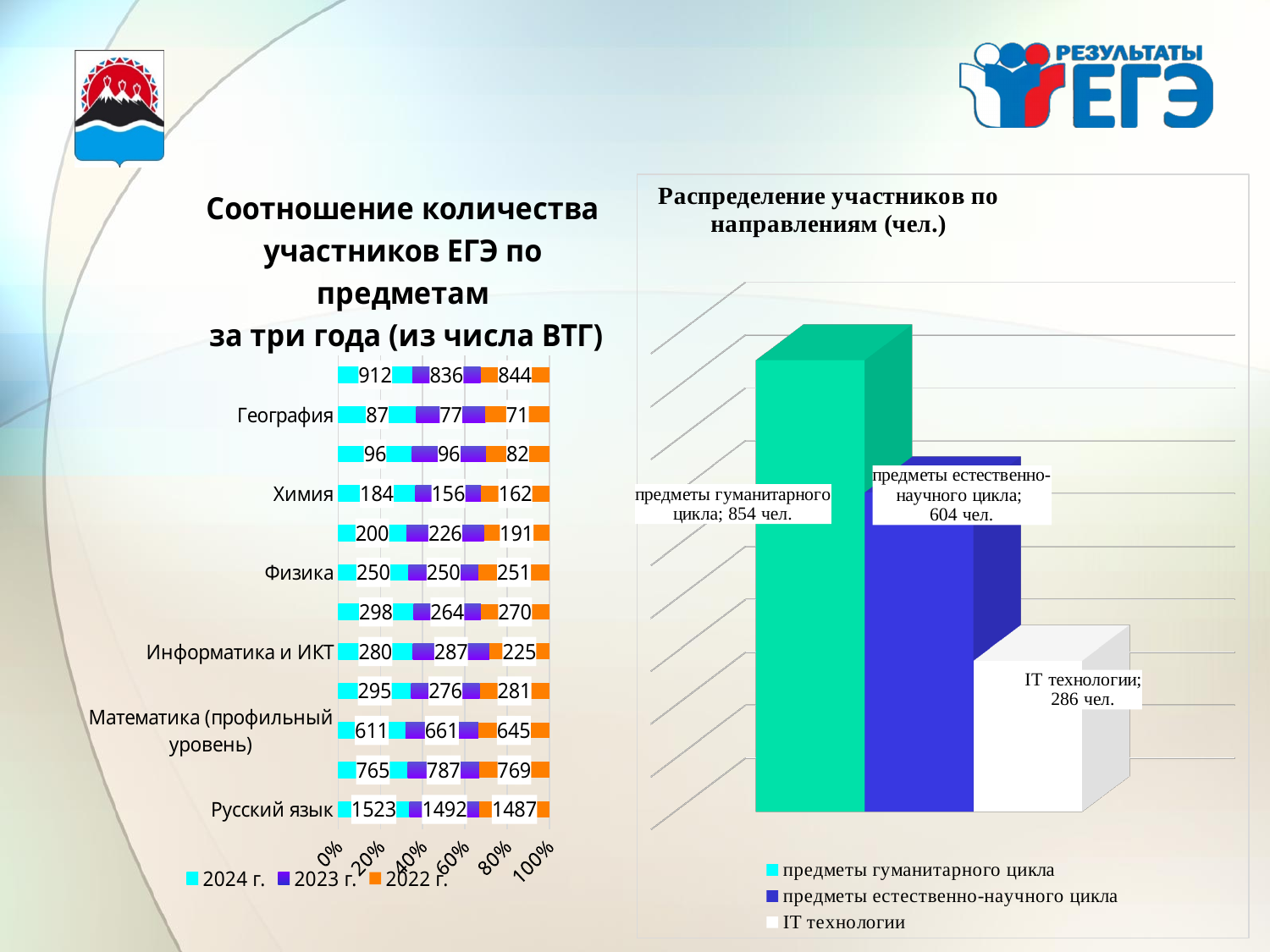
What type of chart is 'Распределение участников по направлениям (чел.)'? bar chart In the chart 'Соотношение количества участников ЕГЭ по предметам за три года', how many series does the legend list? 3 In the chart 'Распределение участников по направлениям (чел.)', how many participants are in 'предметы гуманитарного цикла'? 854 чел. In the chart 'Соотношение количества участников ЕГЭ по предметам за три года', what is the difference between the 2023 г. and 2024 г. values for 'Математика (профильный уровень)'? 50 In the chart 'Распределение участников по направлениям (чел.)', how many categories are shown? 3 In the chart 'Соотношение количества участников ЕГЭ по предметам за три года', which year has the larger value for 'Информатика и ИКТ': 2023 г. or 2022 г.? 2023 г. In the chart 'Соотношение количества участников ЕГЭ по предметам за три года', what is the value for 'Русский язык' in 2024 г.? 1523 In the chart 'Распределение участников по направлениям (чел.)', what is the difference between 'предметы гуманитарного цикла' and 'предметы естественно-научного цикла'? 250 In the chart 'Распределение участников по направлениям (чел.)', which category has the lowest value? IT технологии In the chart 'Распределение участников по направлениям (чел.)', what is the value for 'IT технологии'? 286 чел. In the chart 'Соотношение количества участников ЕГЭ по предметам за три года', what is the value for 'Химия' in 2023 г.? 156 In the chart 'Распределение участников по направлениям (чел.)', which category has the highest value? предметы гуманитарного цикла